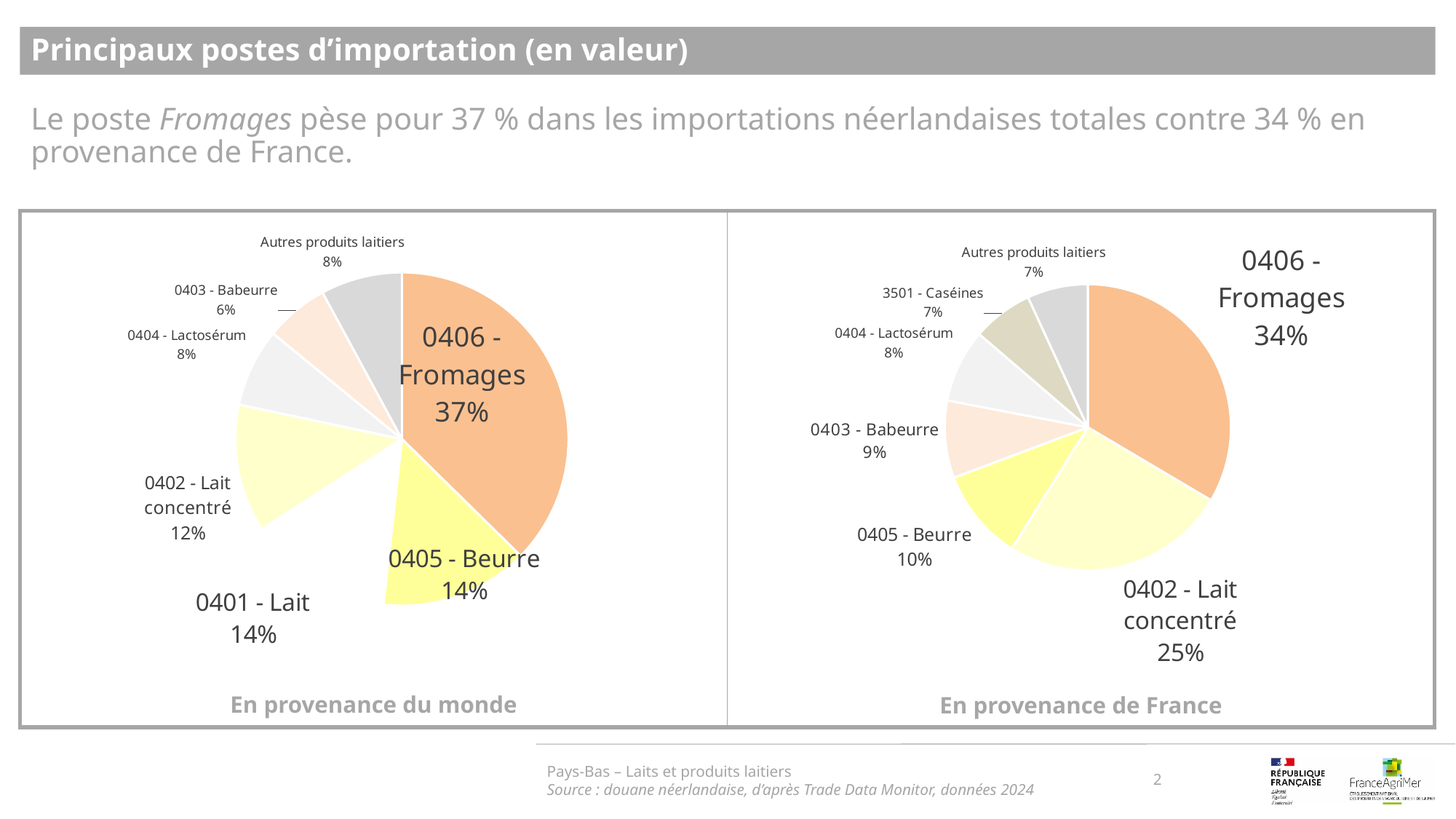
In the 'En provenance de France' chart, which category has the largest share? 0406 - Fromages In the 'En provenance de France' chart, what is the difference in percentage points between 0406 - Fromages and 0402 - Lait concentré? 9 percentage points In the 'En provenance du monde' chart, what share does 0406 - Fromages have? 37% In the 'En provenance du monde' chart, which is larger: 0402 - Lait concentré or 0404 - Lactosérum? 0402 - Lait concentré What type of chart is used in the 'En provenance du monde' panel? Pie chart In the 'En provenance de France' chart, what share does 0402 - Lait concentré have? 25% What is the title of the chart on the right side of the slide? En provenance de France In the 'En provenance du monde' chart, what is the share of 0403 - Babeurre? 6% In the 'En provenance du monde' chart, which category has the largest share? 0406 - Fromages In the 'En provenance du monde' chart, which category has the smallest share? 0403 - Babeurre How many slices does the 'En provenance de France' pie chart have? 7 In the 'En provenance de France' chart, what is the share of 3501 - Caséines? 7%